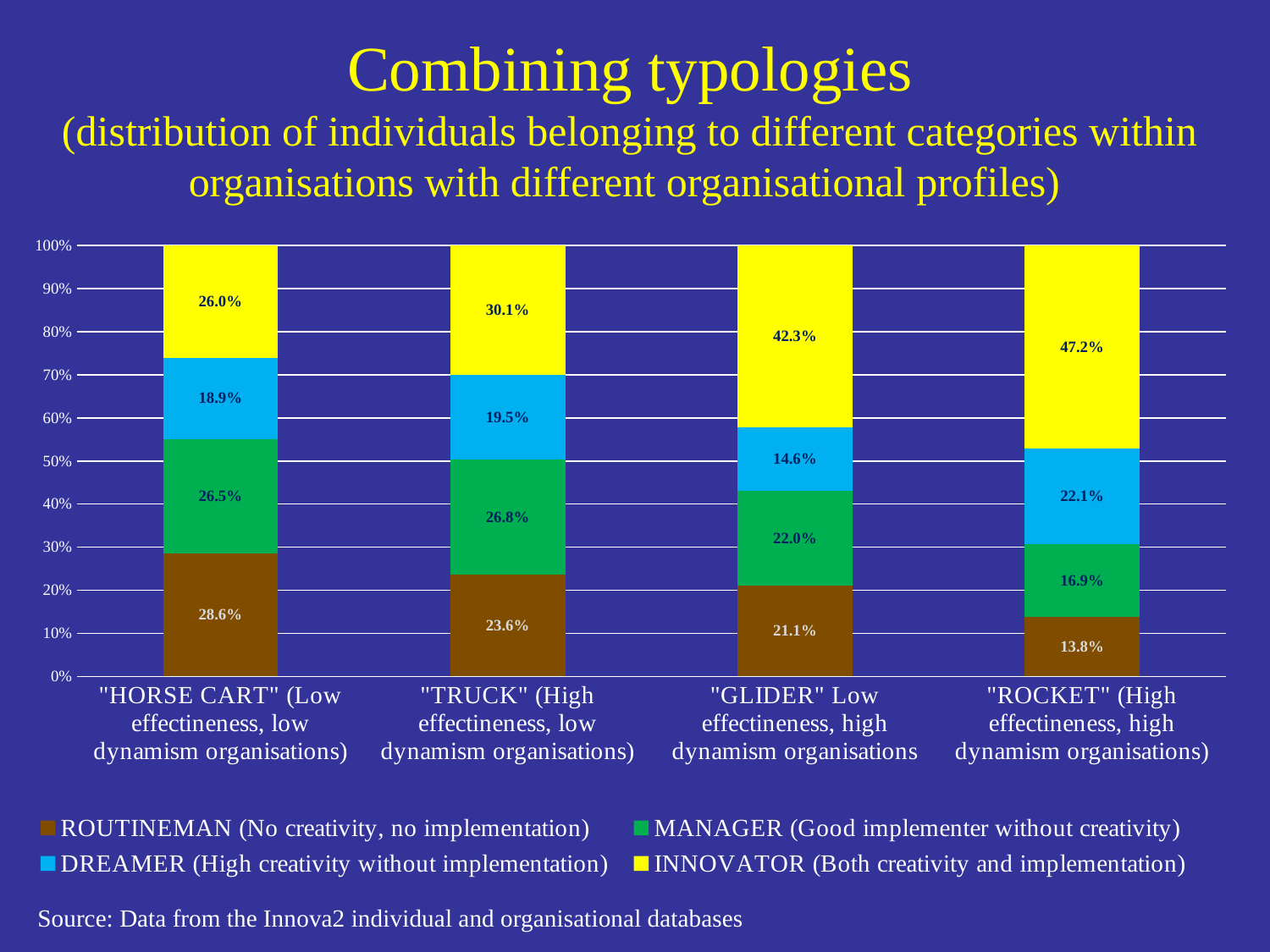
What is the ROUTINEMAN share for "HORSE CART" organisations? 28.6% Which organisational profile has the lowest ROUTINEMAN share? "ROCKET" What kind of chart is shown? Stacked bar chart How many organisational profiles are shown on the x axis? 4 How many series does the legend list? 4 What is the difference between the INNOVATOR share in "ROCKET" and in "HORSE CART" organisations? 21.2% Which organisational profile has the highest INNOVATOR share? "ROCKET" What is the MANAGER share for "GLIDER" organisations? 22.0% What is the DREAMER share for "TRUCK" organisations? 19.5% What is the INNOVATOR share for "ROCKET" organisations? 47.2% Which is larger: the DREAMER share in "ROCKET" or in "GLIDER" organisations? "ROCKET" Which colour represents the INNOVATOR category? Yellow